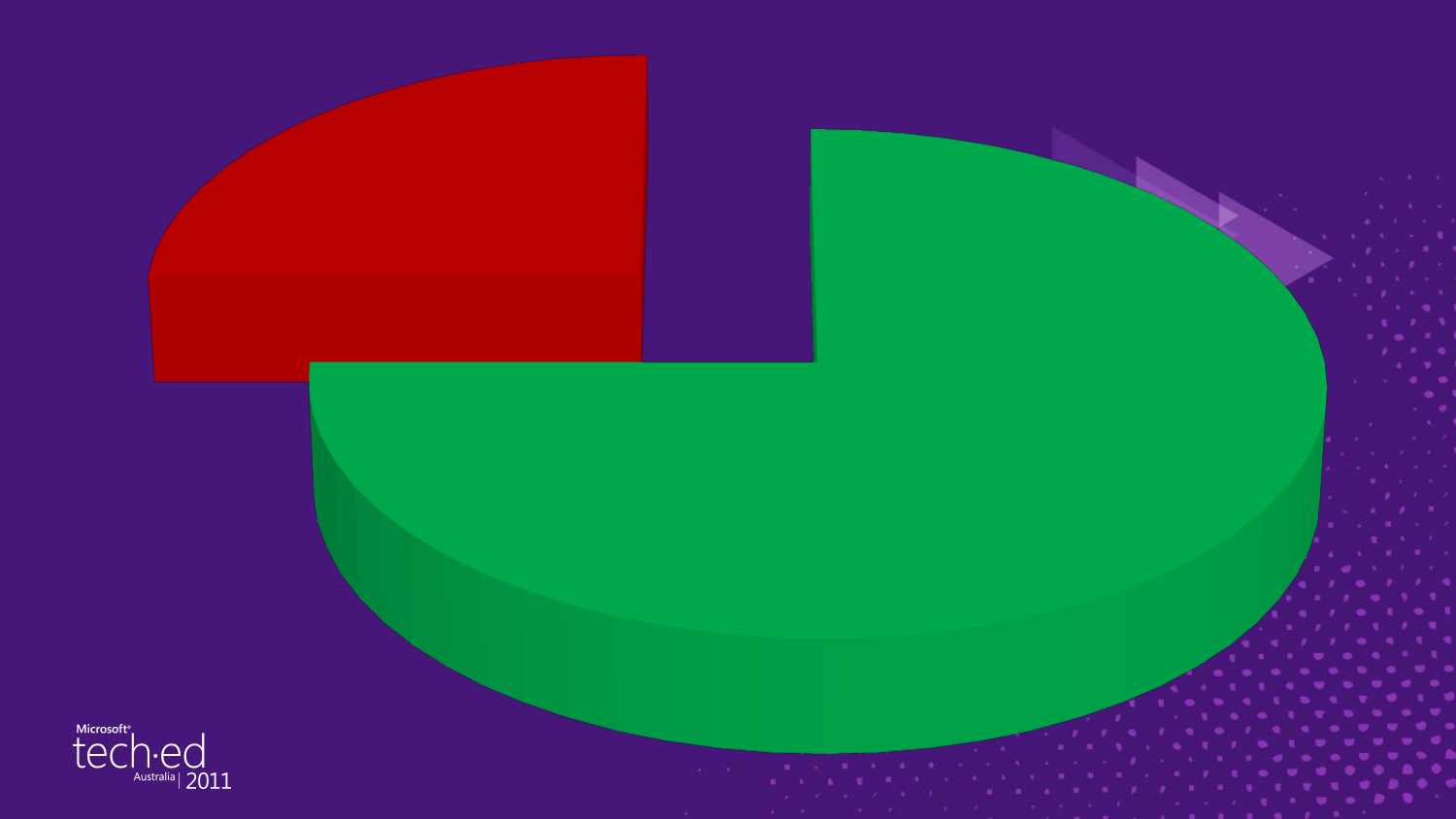
Which slice of the pie chart is pulled out (exploded) from the rest of the pie? the red slice What kind of chart is shown on the slide? pie chart Which slice of the pie chart is the smallest? the red slice How many slices does the pie chart have? 2 Which slice of the pie chart is larger, the green one or the red one? green Does the pie chart display a legend? No Which slice of the pie chart is the largest? the green slice